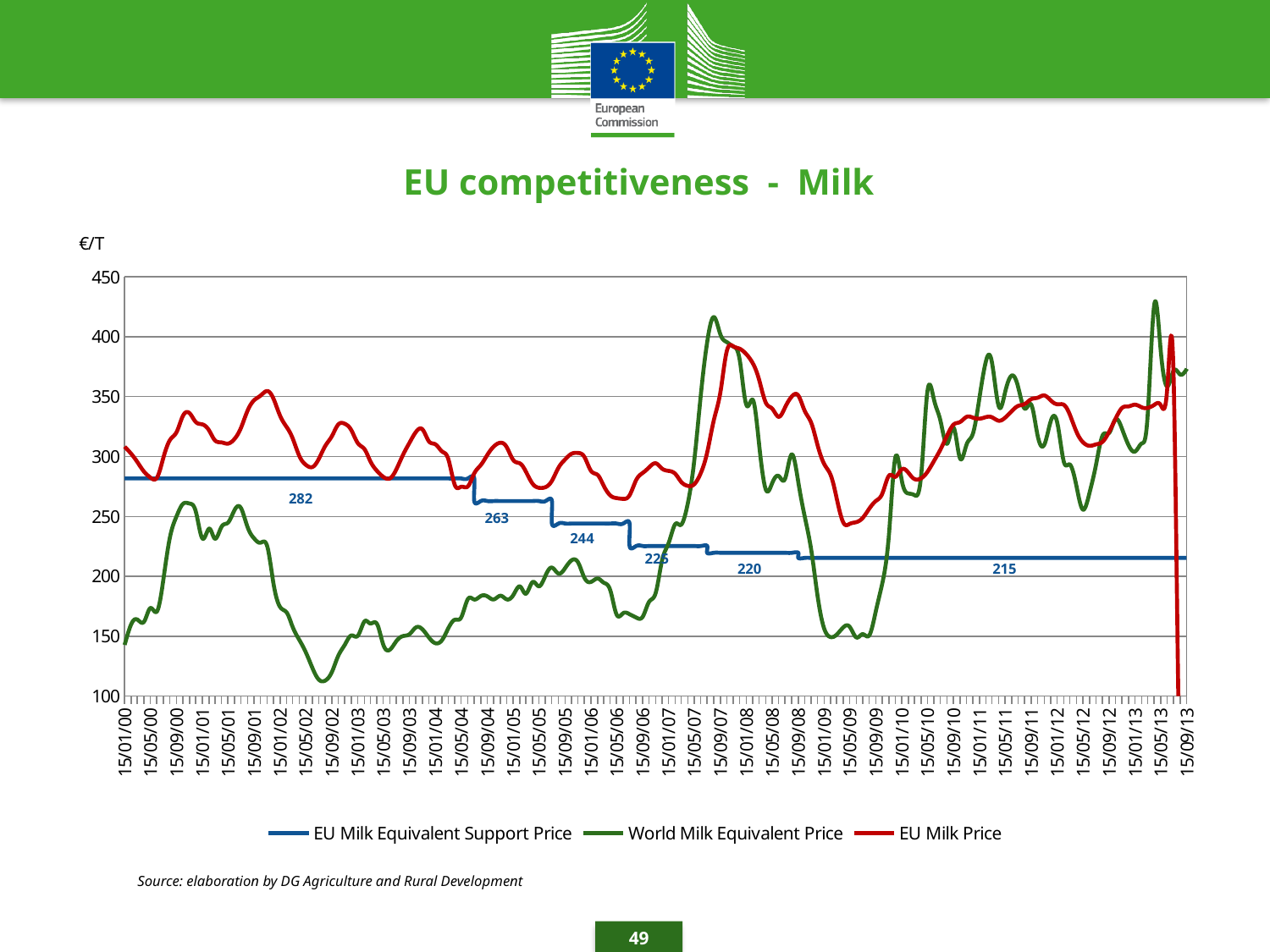
What is the lowest labelled level of the EU Milk Equivalent Support Price? 215 What is the first labelled level of the EU Milk Equivalent Support Price, in force from 2000? 282 What is the highest labelled level of the EU Milk Equivalent Support Price? 282 What unit is shown on the y axis of the chart? €/T What type of chart is shown on the slide? line chart What is the difference between the first labelled support price level (282) and the last (215)? 67 Is the World Milk Equivalent Price at 15/09/02 greater or less than 150? less At 15/01/00, which is higher: the EU Milk Price or the World Milk Equivalent Price? EU Milk Price How many series does the legend list? 3 Does the EU Milk Equivalent Support Price rise or fall over the period shown? fall How many labelled levels does the EU Milk Equivalent Support Price line show? 6 What is the difference between the support price levels labelled 263 and 244? 19